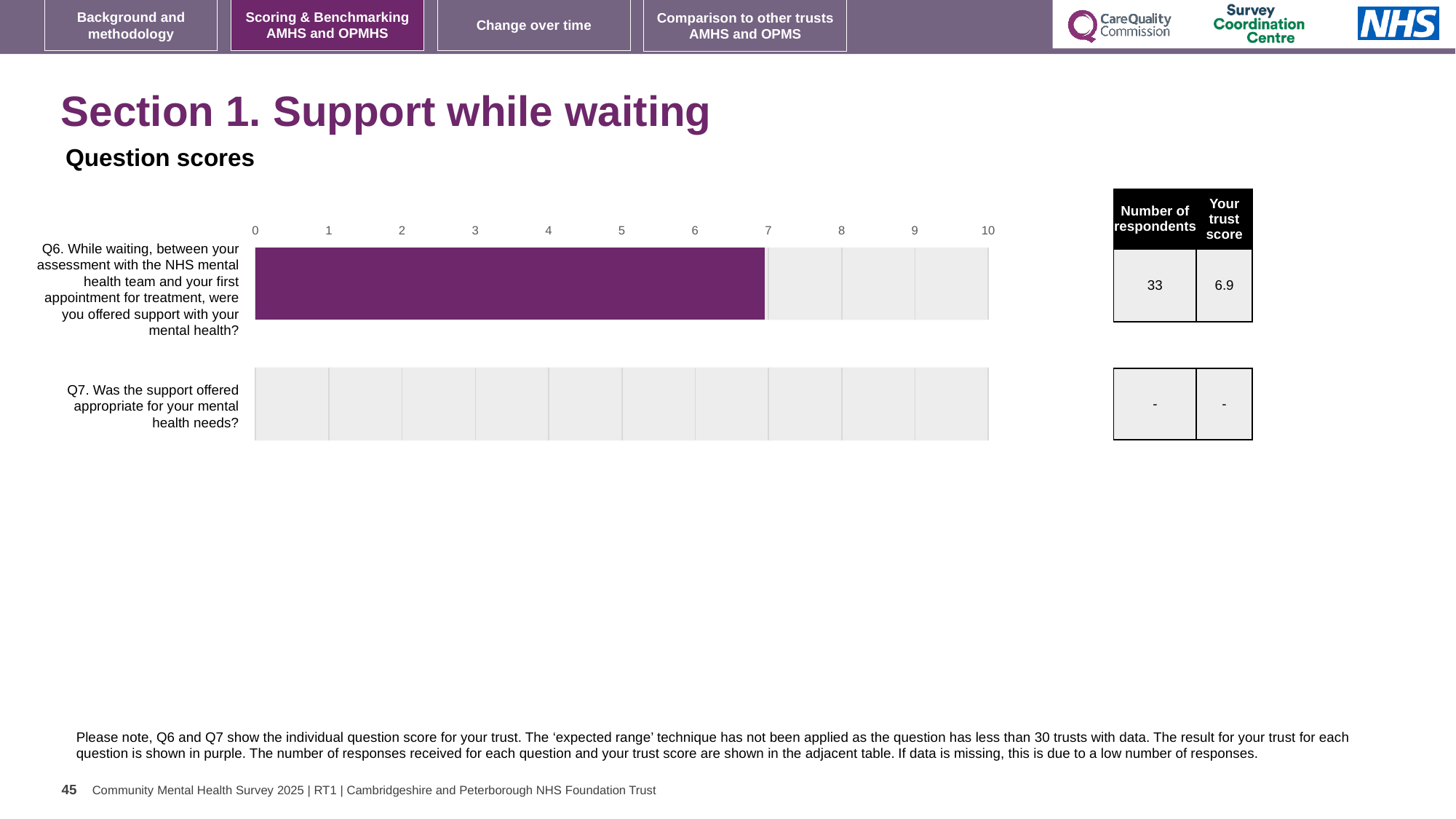
What kind of chart is shown on the slide? bar chart Which question has a plotted bar on the chart? Q6 What is the highest value shown on the chart's axis? 10 How many questions (categories) are plotted on the chart? 2 What colour is the bar for Q6? purple Is the value for Q6 greater or less than 5? greater What is shown in the table for the trust score of Q7? - Is the value for Q6 greater or less than 8? less What is the trust score for Q6 shown in the adjacent table? 6.9 How many respondents answered Q6 according to the table? 33